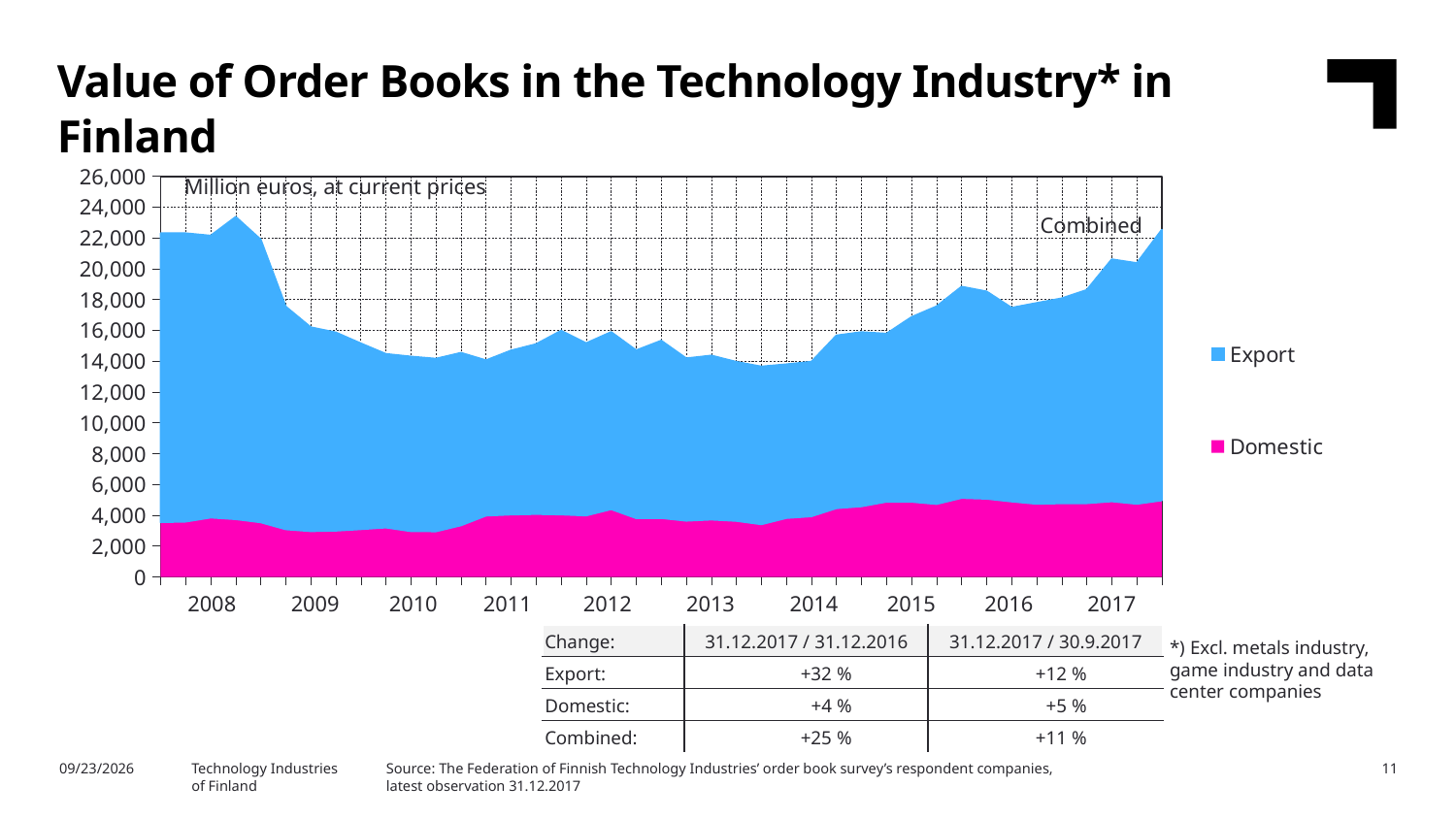
What unit is stated for the values in the chart? Million euros, at current prices What kind of chart is shown on the slide? Stacked area chart Does the combined value of order books rise or fall from 2013 to 2017? rise Is the combined value at the start of 2008 greater or less than 20,000? greater Which two series are listed in the legend? Export and Domestic Is the combined value at the end of 2017 greater or less than 20,000? greater Which series is larger at the end of 2017, Export or Domestic? Export Is the combined value in 2013 greater or less than 16,000? less Does the combined value of order books rise or fall from 2008 to 2009? fall How many series does the legend list? 2 How many years are labelled on the x axis? 10